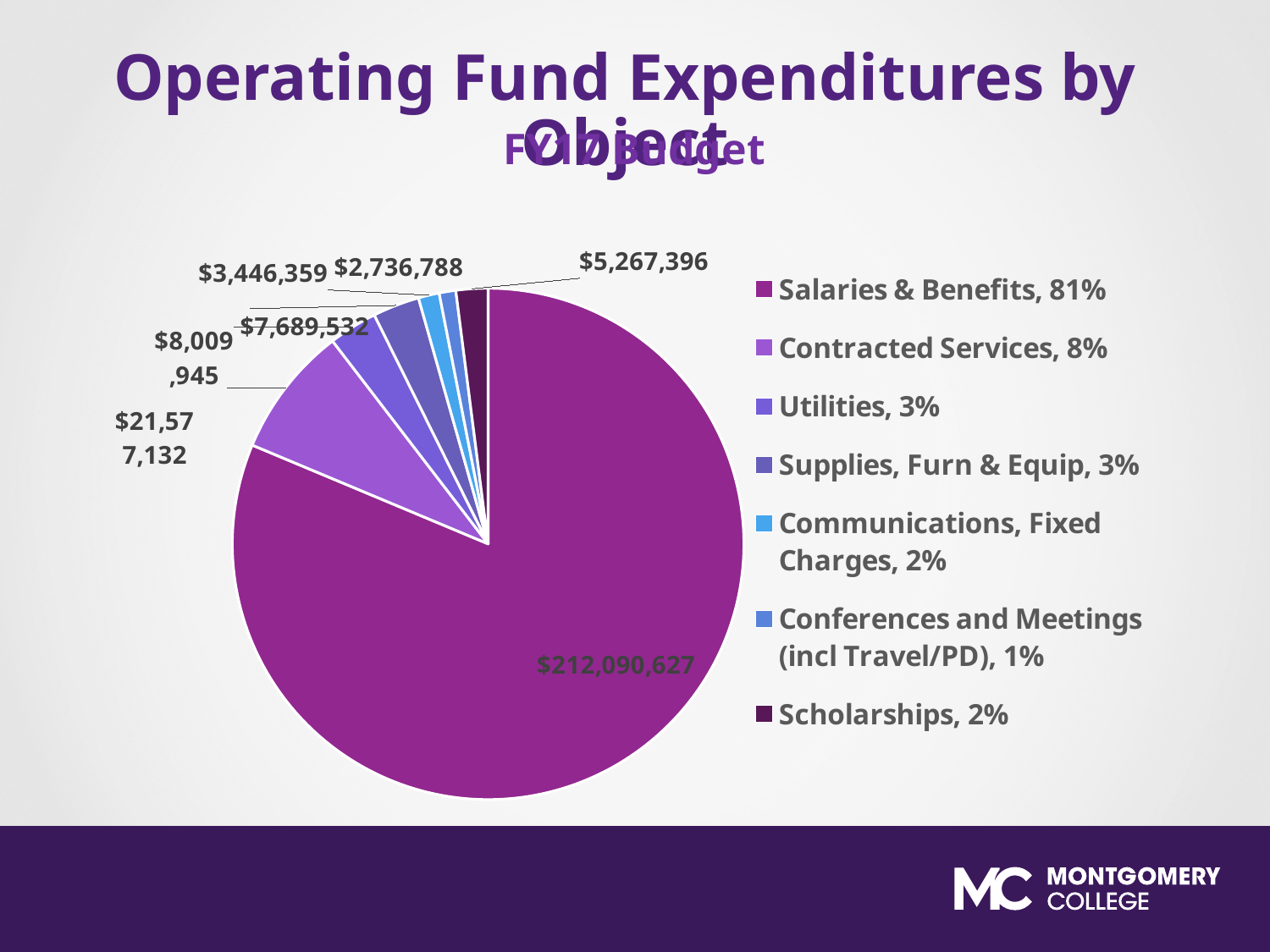
What is the value shown for Contracted Services? $21,577,132 What is the value shown for Scholarships? $5,267,396 How many categories does the legend list? 7 What type of chart is shown on the slide? Pie chart Which category has the smallest share of the pie? Conferences and Meetings (incl Travel/PD) Which category has the largest share of the pie? Salaries & Benefits What is the value shown for Salaries & Benefits? $212,090,627 Which is larger, the value for Utilities or the value for Supplies, Furn & Equip? Utilities What is the value shown for Utilities? $8,009,945 What percentage share of the pie does Salaries & Benefits have? 81% What is the difference between the Salaries & Benefits value and the Contracted Services value? $190,513,495 What percentage share of the pie does Contracted Services have? 8%